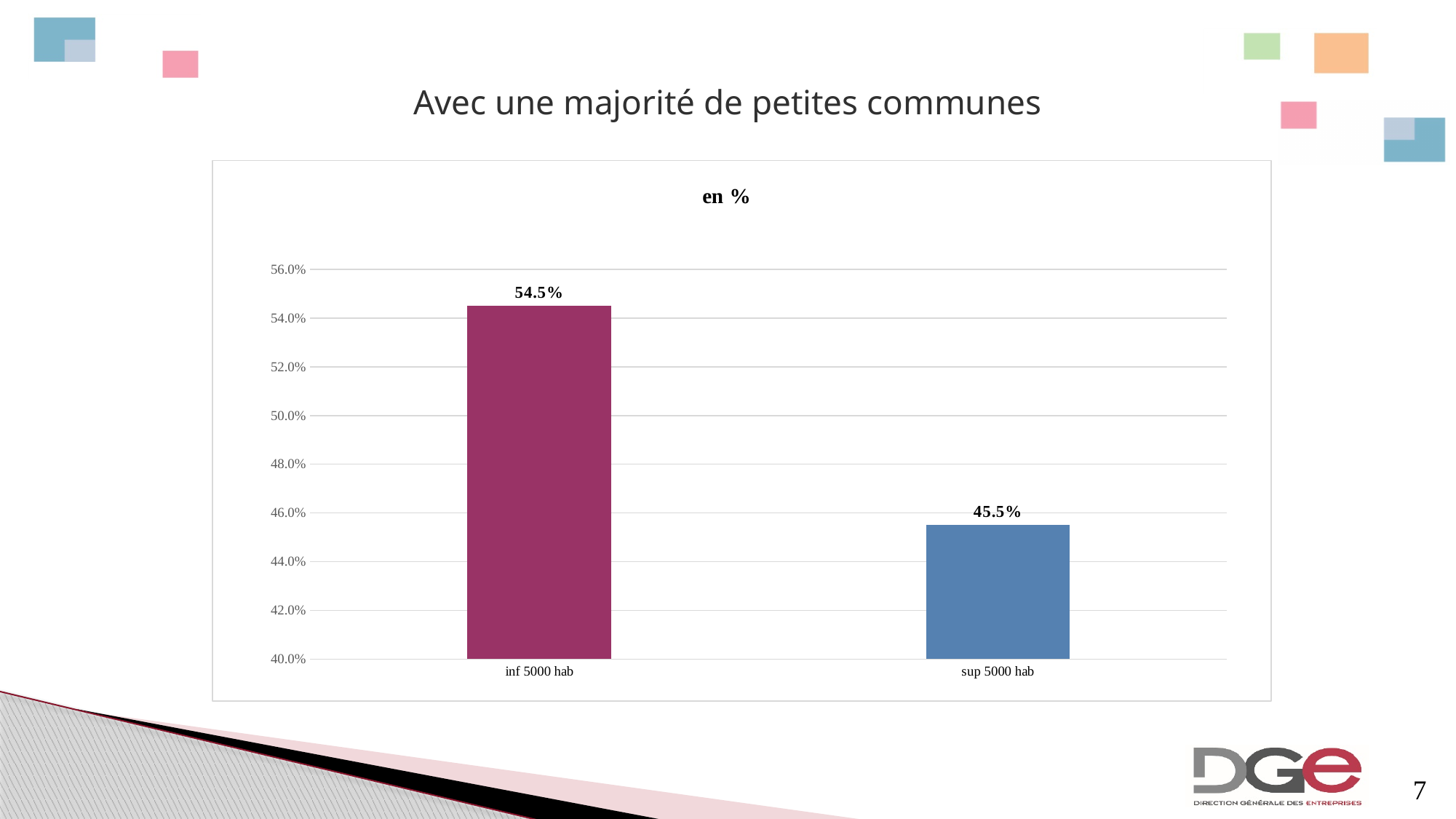
What is the title of the chart? en % What colour is the bar for sup 5000 hab? blue Which category has the highest value? inf 5000 hab How many categories are shown on the chart? 2 What kind of chart is shown on the slide? bar chart What is the value for inf 5000 hab? 54.5% What is the difference between the values for inf 5000 hab and sup 5000 hab? 9.0% What is the value for sup 5000 hab? 45.5% Which category has the lowest value? sup 5000 hab Which is larger, the value for inf 5000 hab or the value for sup 5000 hab? inf 5000 hab Is the value for sup 5000 hab greater or less than 50.0%? less Is the value for inf 5000 hab greater or less than 52.0%? greater